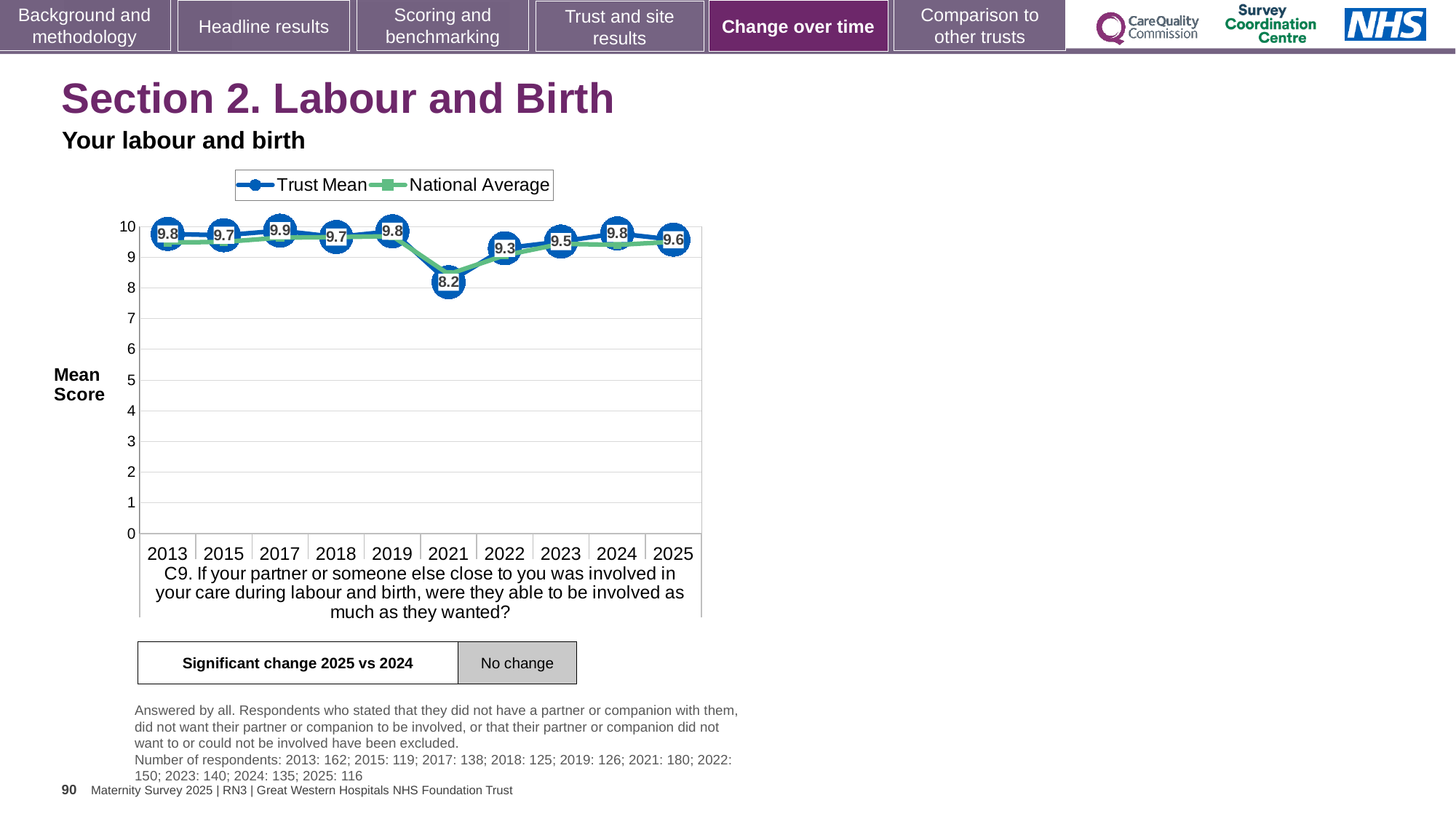
Which year has the larger Trust Mean score, 2022 or 2023? 2023 What is the difference between the Trust Mean scores for 2024 and 2025? 0.2 What is the Trust Mean score for 2017? 9.9 In which year is the Trust Mean score highest? 2017 What kind of chart is shown on the slide? Line chart How many series does the chart legend list? 2 What is the Trust Mean score for 2021? 8.2 What is the difference between the Trust Mean scores for 2019 and 2021? 1.6 Is the National Average value for 2021 greater or less than 9? less How many years are shown on the x axis of the chart? 10 What is the Trust Mean score for 2025? 9.6 In which year is the Trust Mean score lowest? 2021